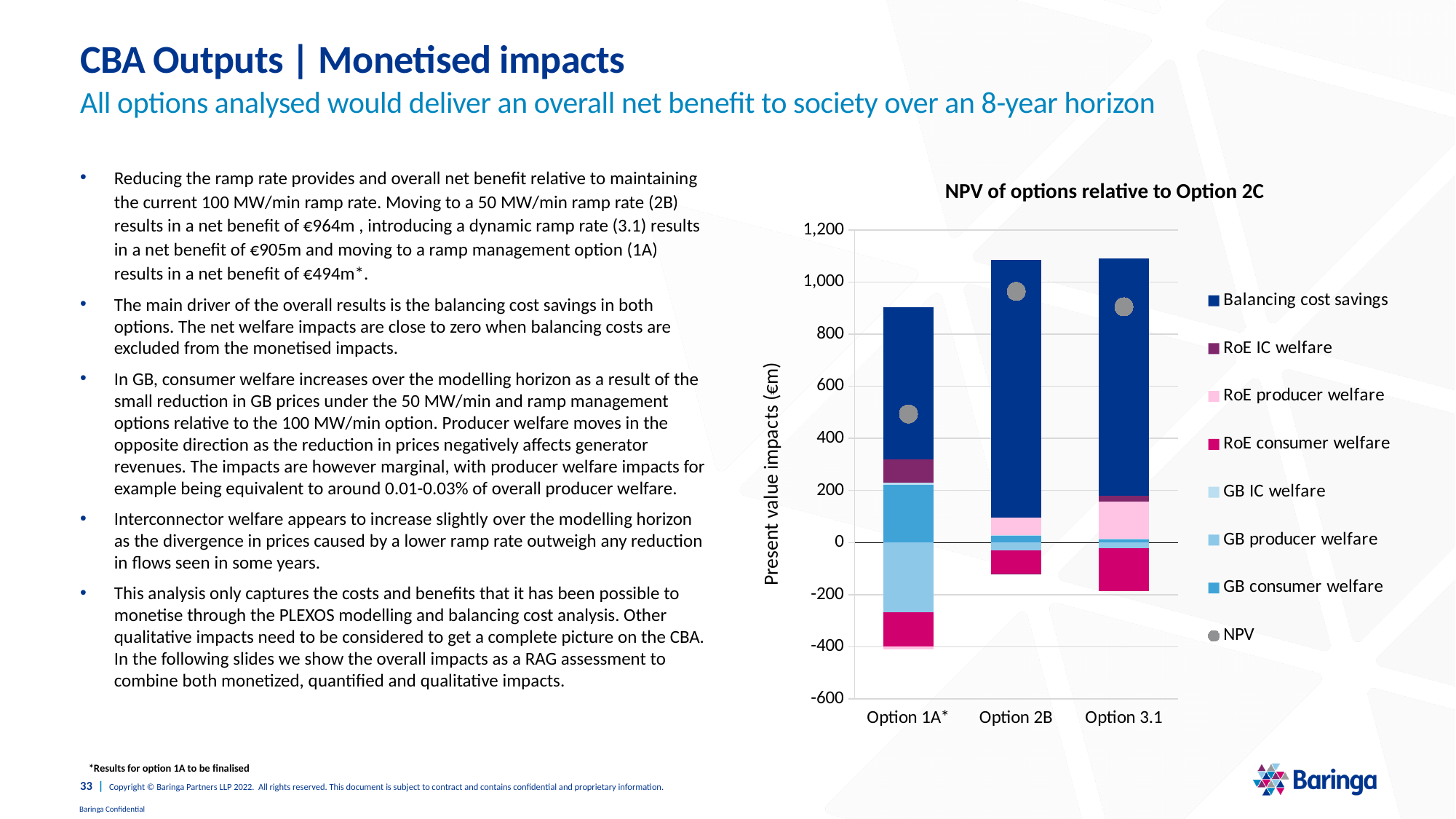
What is the title of the chart? NPV of options relative to Option 2C How many options (categories) are shown on the x axis of the chart? 3 Is the top of the stacked bar for Option 1A* greater or less than 1,000? less Which option has the lowest NPV marker in the chart? Option 1A* Which option has the highest NPV marker in the chart? Option 2B Is the NPV marker for Option 2B greater or less than 800? greater Which has the larger NPV marker, Option 1A* or Option 3.1? Option 3.1 Is the NPV marker for Option 1A* greater or less than 600? less What type of chart is shown on the slide? Stacked bar chart What is the label of the vertical axis of the chart? Present value impacts (€m) How many entries does the chart legend list? 8